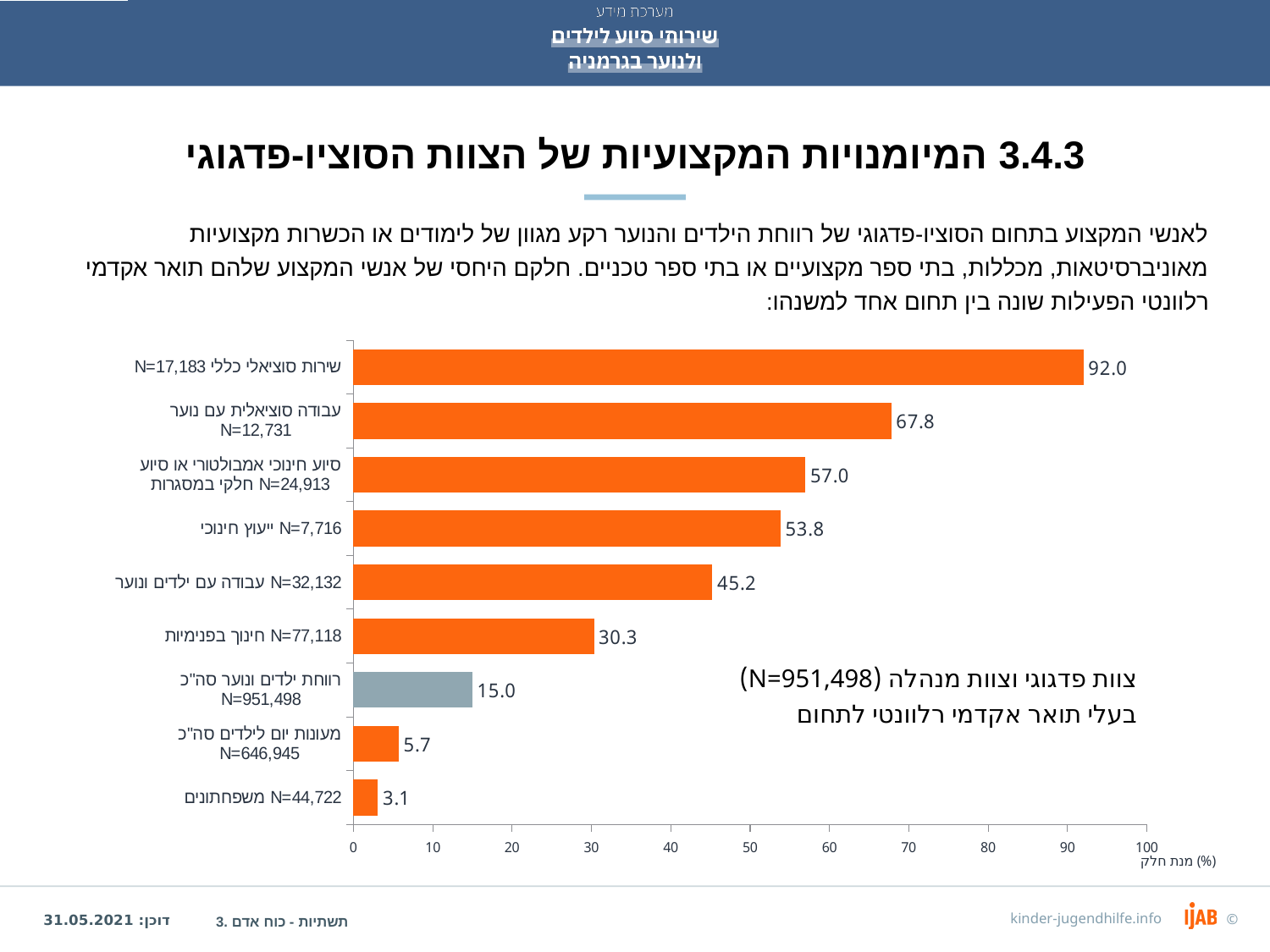
How many categories (bars) does the chart show? 9 What is the value for עבודה סוציאלית עם נוער (N=12,731)? 67.8 What is the difference between the values for עבודה עם ילדים ונוער (45.2) and חינוך בפנימיות (30.3)? 14.9 Which is larger: the value for סיוע חינוכי אמבולטורי או סיוע חלקי במסגרות or the value for ייעוץ חינוכי? סיוע חינוכי אמבולטורי או סיוע חלקי במסגרות Which category has the highest value? שירות סוציאלי כללי (N=17,183) Which category has the lowest value? משפחתונים (N=44,722) What is the value for ייעוץ חינוכי (N=7,716)? 53.8 What is the value for משפחתונים (N=44,722)? 3.1 Which bar is coloured grey instead of orange? רווחת ילדים ונוער סה"כ (N=951,498) What is the value for שירות סוציאלי כללי (N=17,183)? 92.0 What kind of chart is shown on the slide? bar chart What is the value for רווחת ילדים ונוער סה"כ (N=951,498)? 15.0